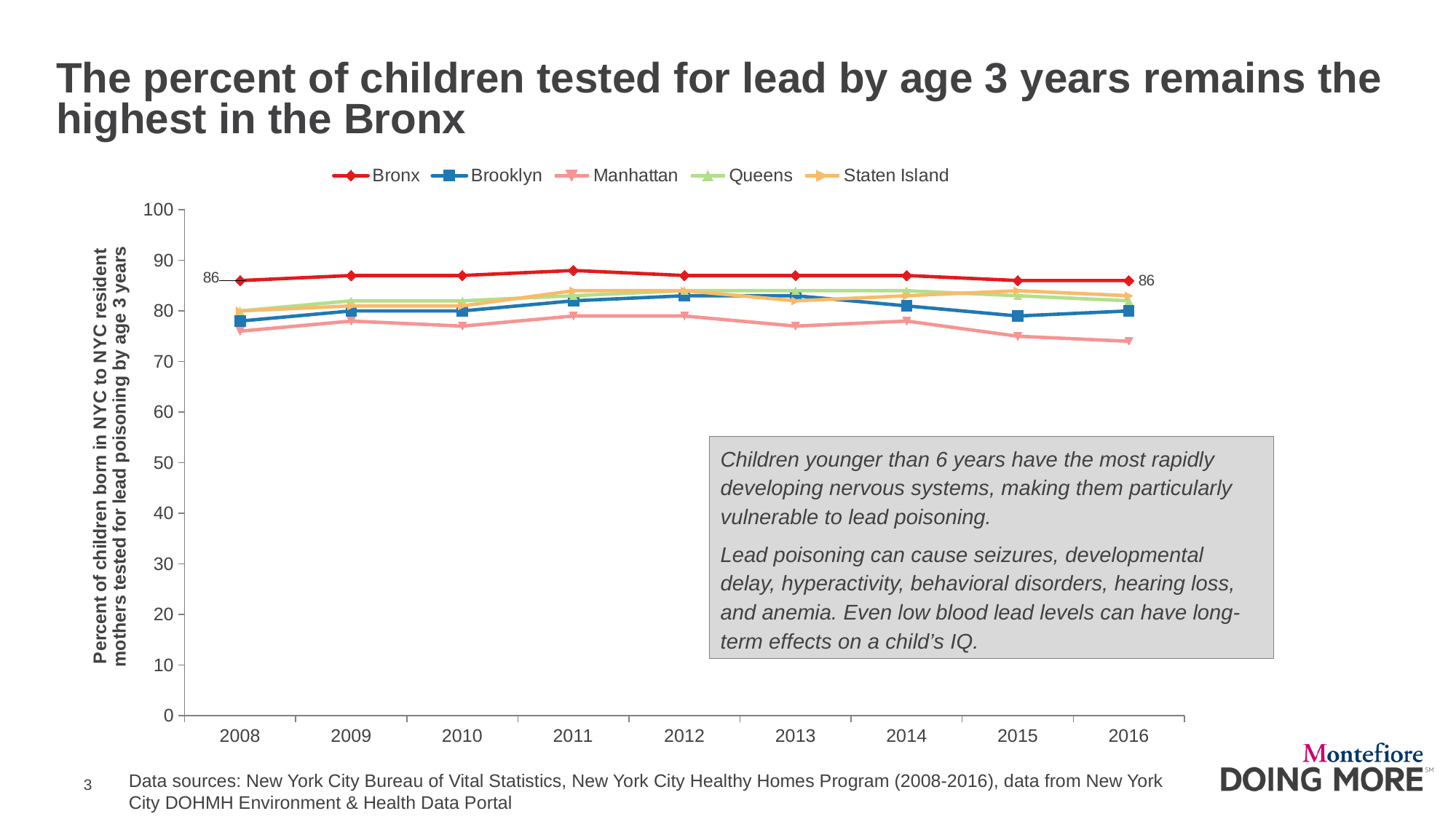
Does the Manhattan line rise or fall from 2014 to 2016? fall What colour is the Bronx line in the legend? red How many series does the legend list? 5 What kind of chart is shown on the slide? line chart Which borough has the highest value in 2016? Bronx What is the difference between the Bronx value in 2016 and in 2008? 0 Which is larger in 2012, the value for the Bronx or the value for Manhattan? Bronx Is the value for Manhattan in 2016 greater or less than 80? less How many years are shown on the x axis? 9 What is the value for the Bronx in 2016? 86 What is the value for the Bronx in 2008? 86 Which borough has the lowest value in 2016? Manhattan